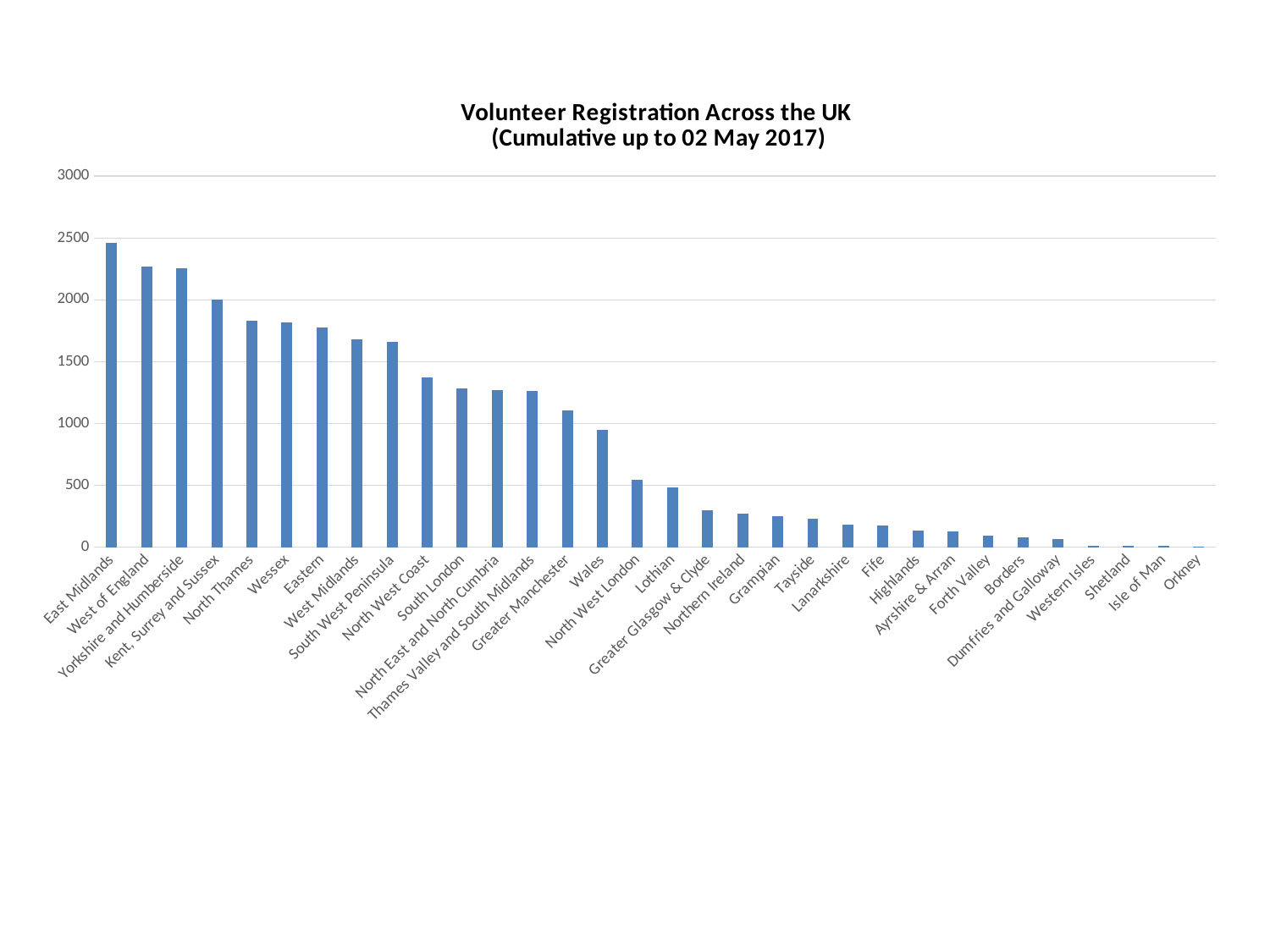
How many regions are plotted on the chart? 32 Which has a higher value, Lothian or Grampian? Lothian Is the value for East Midlands greater or less than 2000? greater Which has a higher value, North Thames or Greater Manchester? North Thames Which region has the highest volunteer registration? East Midlands Do the values rise or fall moving from left to right along the x axis? fall Is the value for Greater Manchester greater or less than 1000? greater Is the value for Wales greater or less than 1000? less What is the title of the chart? Volunteer Registration Across the UK (Cumulative up to 02 May 2017) What kind of chart is shown on the slide? bar chart